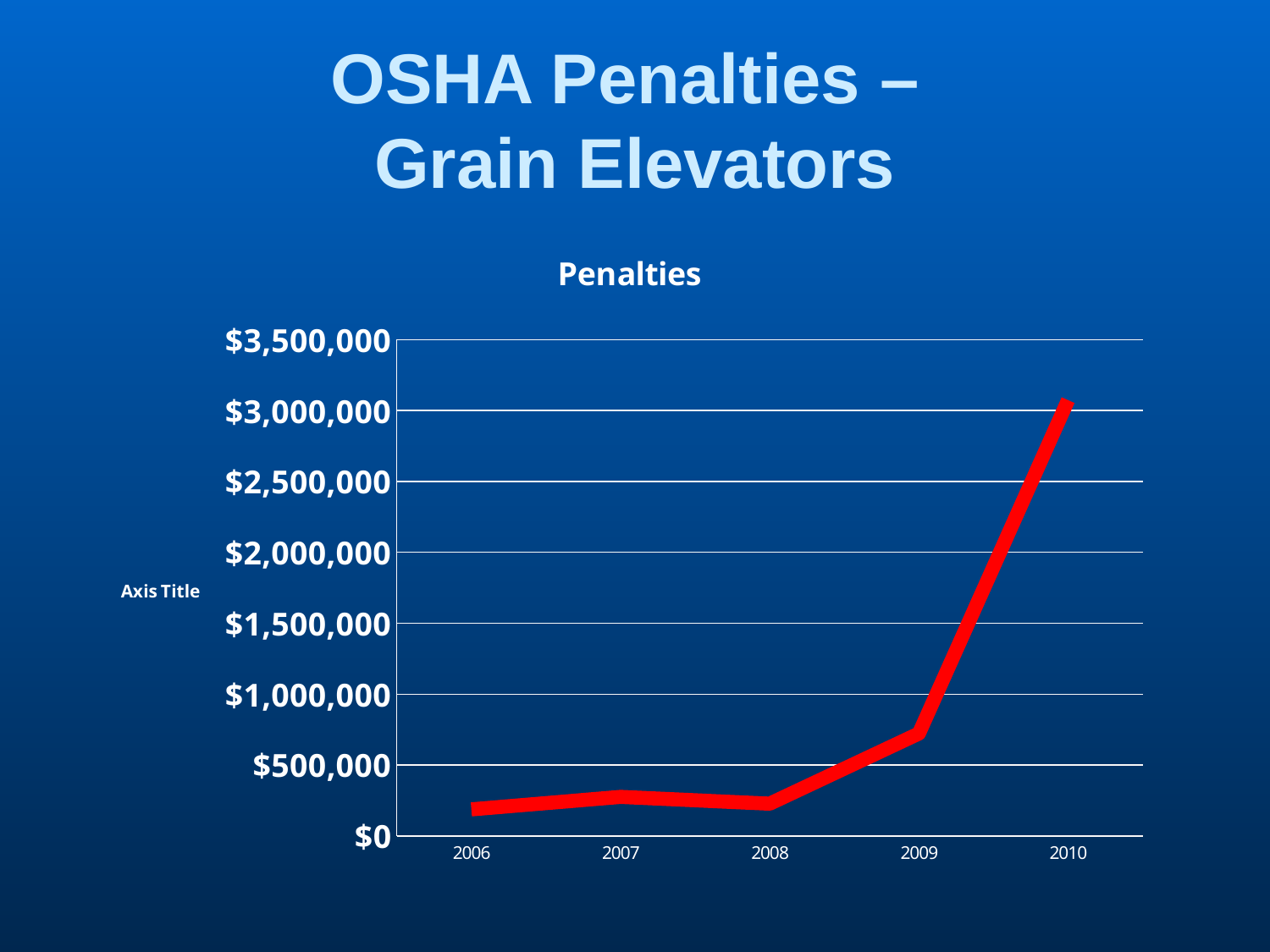
Is the value for 2009 greater or less than $1,000,000? less Which year has the larger penalty value, 2008 or 2009? 2009 What kind of chart is shown on the slide? line chart Is the value for 2010 greater or less than $2,500,000? greater Which year has the highest penalty value? 2010 What is the title of the chart? Penalties Is the value for 2006 greater or less than $500,000? less Do the penalty values generally rise or fall from 2006 to 2010? rise How many years are plotted on the x axis? 5 What colour is the line in the chart? red